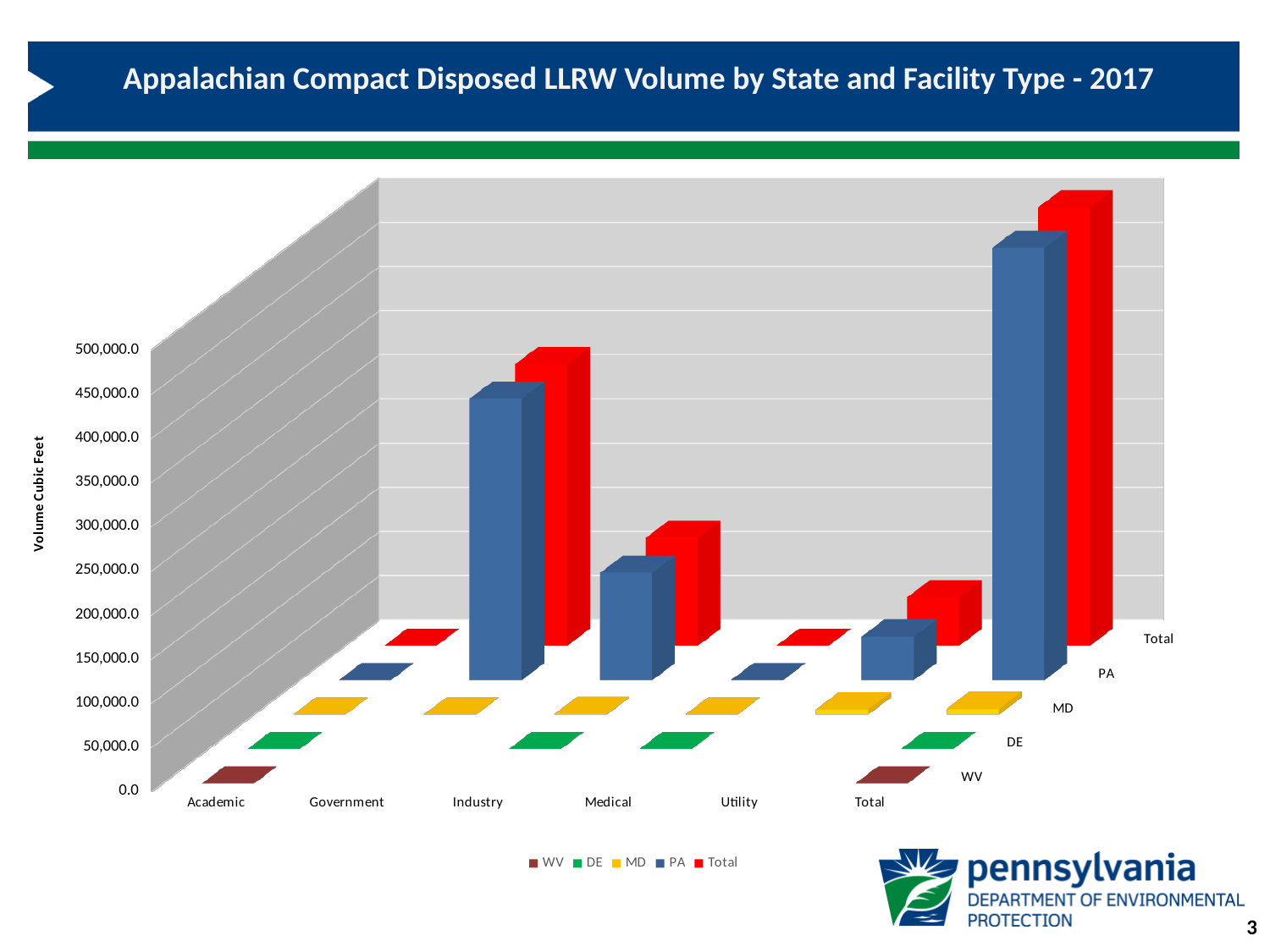
What is the label on the vertical axis? Volume Cubic Feet Is the PA value for Medical greater or less than 200,000? less Is the PA value for Industry greater or less than 250,000? less Is the Total series value for Industry greater or less than 200,000? less What is the title of the chart? Appalachian Compact Disposed LLRW Volume by State and Facility Type - 2017 Excluding the Total category, which facility type has the highest PA value? Government How many categories are shown along the x axis? 6 How many series does the legend list? 5 What kind of chart is shown on the slide? bar chart Which is larger for the PA series, Industry or Medical? Industry Which category has the highest value in the Total series? Total